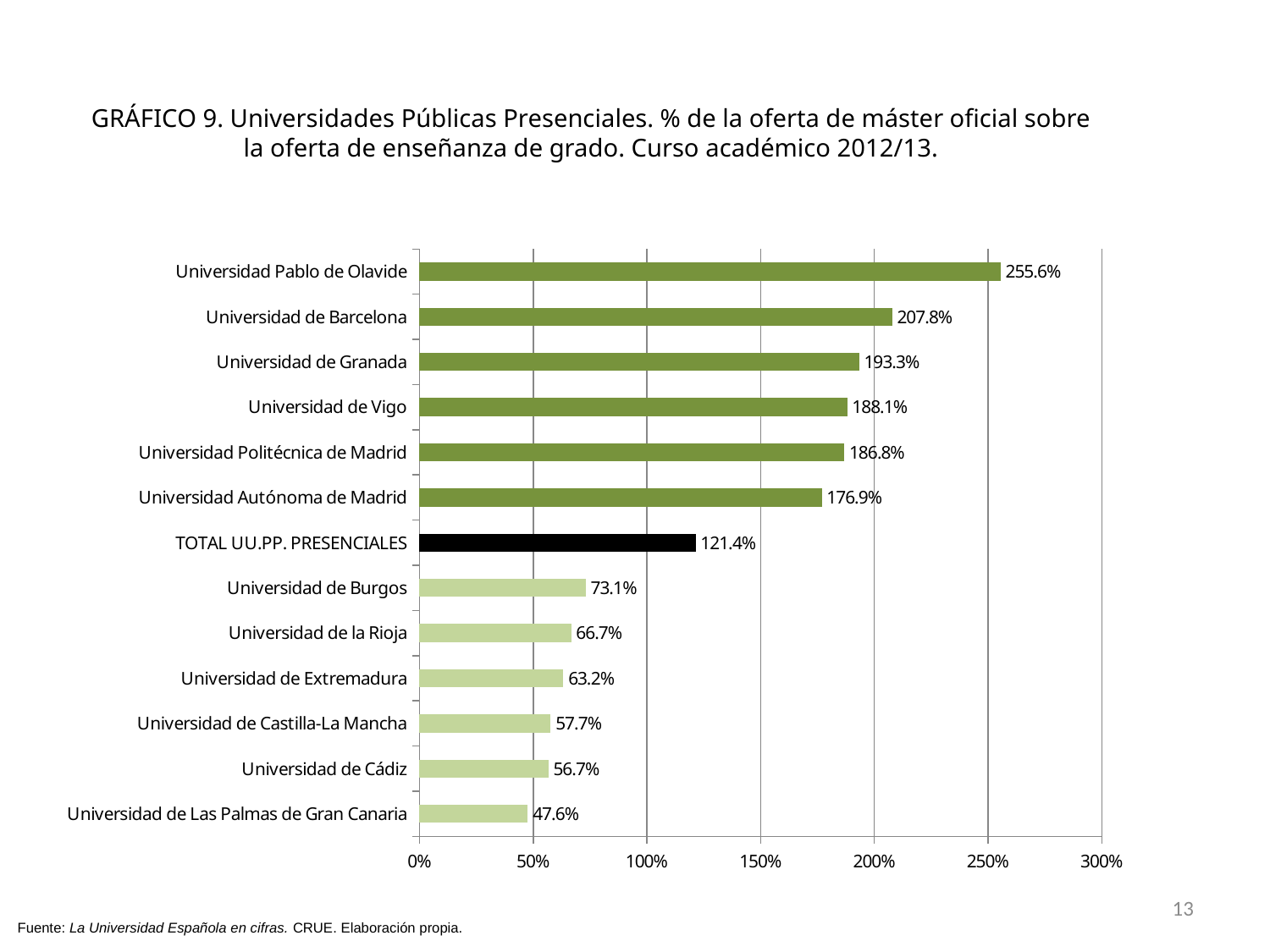
What is the value for Universidad de Cádiz? 56.7% Which category has the highest value? Universidad Pablo de Olavide What kind of chart is shown on the slide? Bar chart Which bar is coloured black? TOTAL UU.PP. PRESENCIALES Which category has the lowest value? Universidad de Las Palmas de Gran Canaria Which is larger, the value for Universidad de Burgos or Universidad de la Rioja? Universidad de Burgos What is the value for Universidad Pablo de Olavide? 255.6% What is the difference between the values for Universidad de Barcelona and Universidad de Granada? 14.5% What is the value for TOTAL UU.PP. PRESENCIALES? 121.4% Is the value for Universidad Autónoma de Madrid greater or less than 150%? greater What is the difference between the values for Universidad Pablo de Olavide and TOTAL UU.PP. PRESENCIALES? 134.2% How many categories are shown in the chart? 13